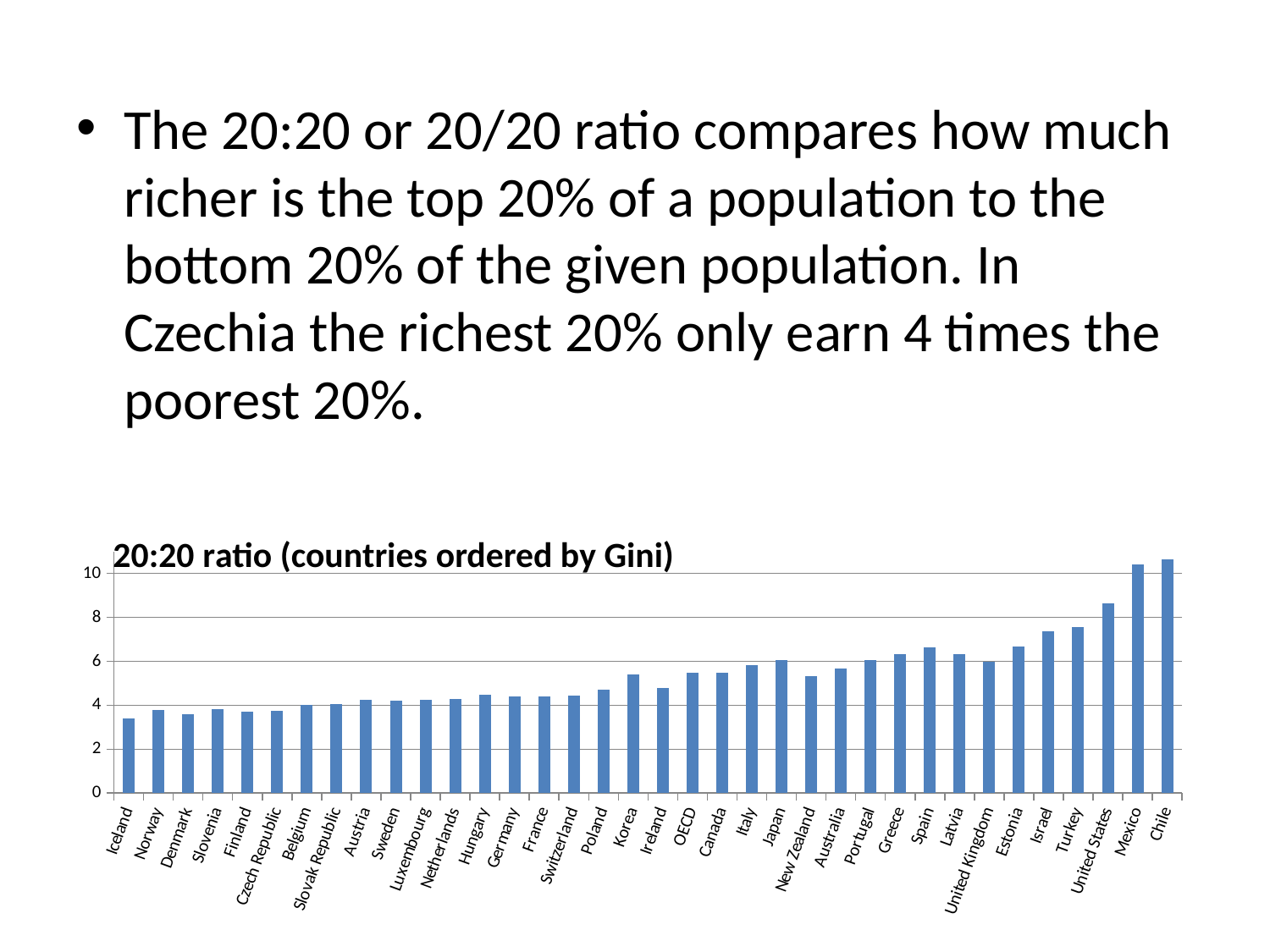
Which has a larger 20:20 ratio, Korea or Ireland? Korea Is the value for Turkey greater or less than 8? less Do the values generally rise or fall from left to right along the x axis? rise What is the title of the chart? 20:20 ratio (countries ordered by Gini) Is the value for United States greater or less than 8? greater Which has a larger 20:20 ratio, Mexico or Turkey? Mexico What kind of chart is shown on the slide? bar chart Is the value for Spain greater or less than 6? greater Which category has the highest 20:20 ratio in the chart? Chile How many countries/categories are plotted in the chart? 36 Which category has the lowest 20:20 ratio in the chart? Iceland